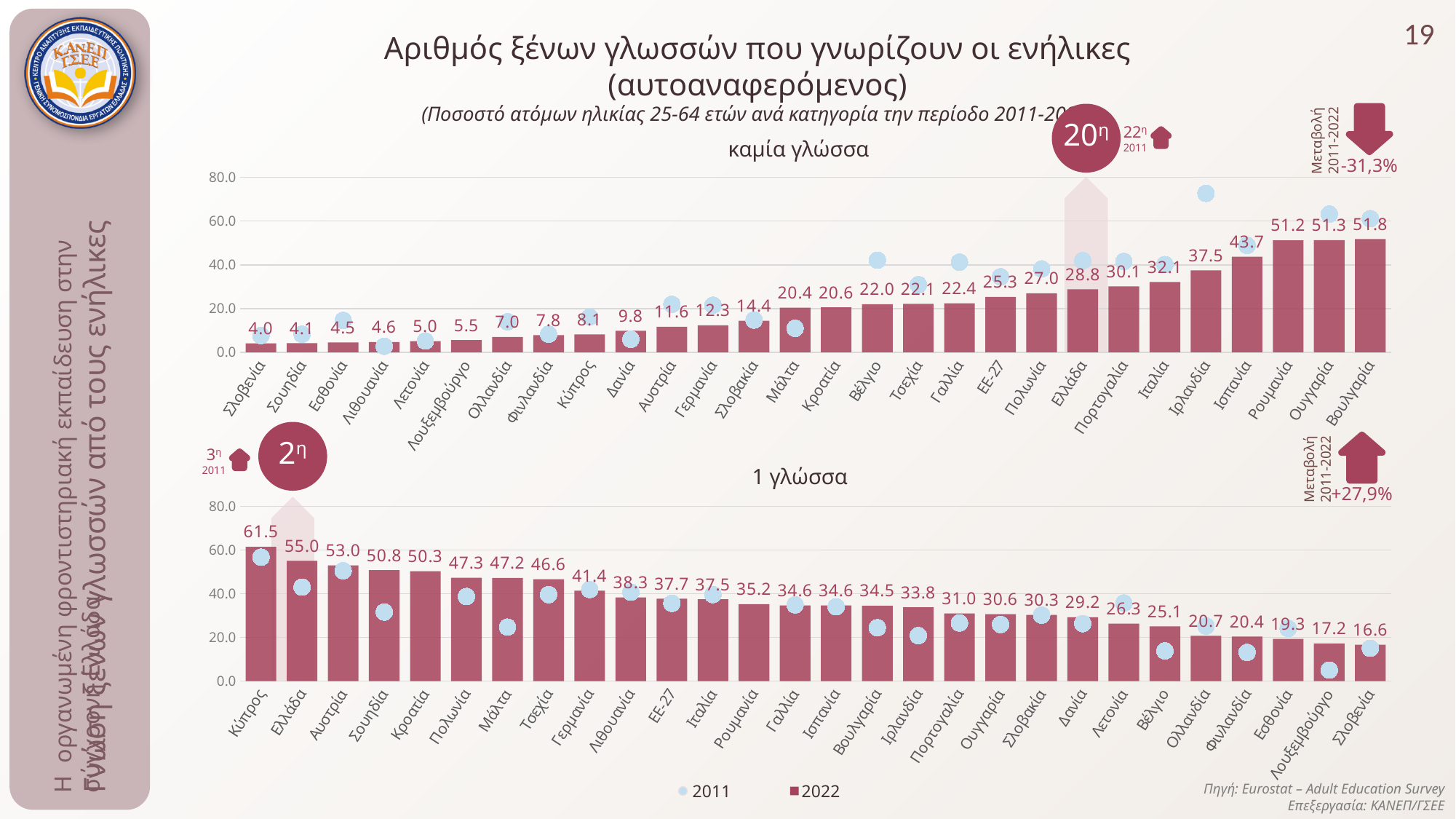
In the 'καμία γλώσσα' chart, which country has the highest 2022 value? Βουλγαρία In the '1 γλώσσα' chart, is the 2011 value (dot) for Λουξεμβούργο greater or less than 20.0? less In the 'καμία γλώσσα' chart, what is the difference between the 2022 values for Ισπανία and Ιταλία? 11.6 In the 'καμία γλώσσα' chart, which country has the lowest 2022 value? Σλοβενία How many series does the legend at the bottom of the slide list? 2 In the '1 γλώσσα' chart, what is the difference between the 2022 values for Ελλάδα and ΕΕ-27? 17.3 How many countries/categories are shown on the x axis of the '1 γλώσσα' chart? 28 In the 'καμία γλώσσα' chart, is the 2011 value (dot) for Ιρλανδία greater or less than 60.0? greater In the '1 γλώσσα' chart, what is the 2022 value for Κύπρος? 61.5 In the '1 γλώσσα' chart, which has the larger 2022 value, Ελλάδα or Αυστρία? Ελλάδα In the 'καμία γλώσσα' chart, what is the 2022 value for Ελλάδα? 28.8 In the '1 γλώσσα' chart, which country has the lowest 2022 value? Σλοβενία